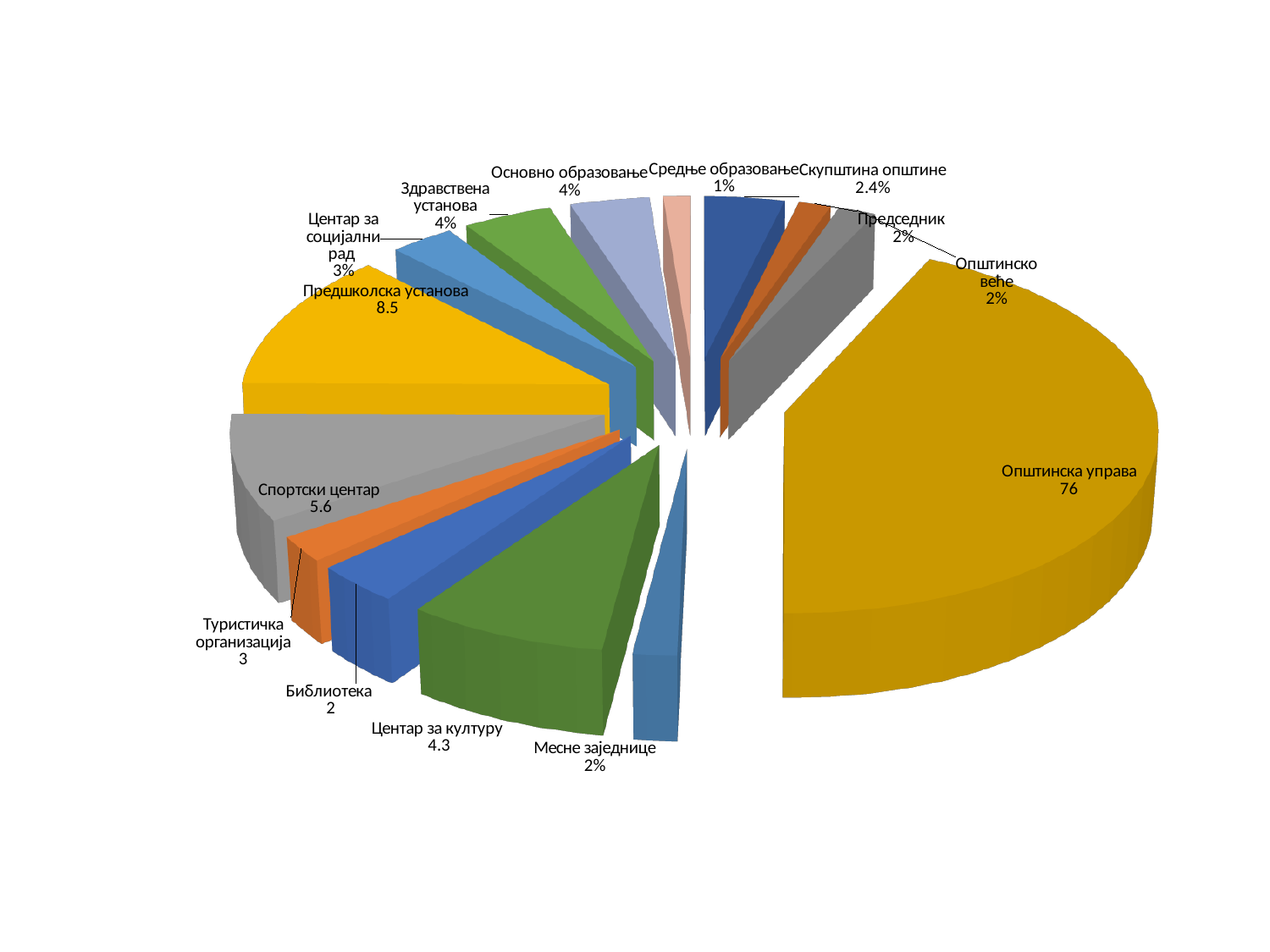
How many categories (slices) does the pie chart have? 14 Which category has the smallest slice of the pie? Средње образовање What value is shown for Спортски центар? 5.6 What value is shown for Општинска управа? 76 Which is larger, the value for Предшколска установа or the value for Спортски центар? Предшколска установа Which category has the largest slice of the pie? Општинска управа What value is shown for Скупштина општине? 2.4% What is the difference between the values for Предшколска установа and Спортски центар? 2.9 What value is shown for Предшколска установа? 8.5 What value is shown for Центар за културу? 4.3 What kind of chart is shown on the slide? pie chart What value is shown for Средње образовање? 1%